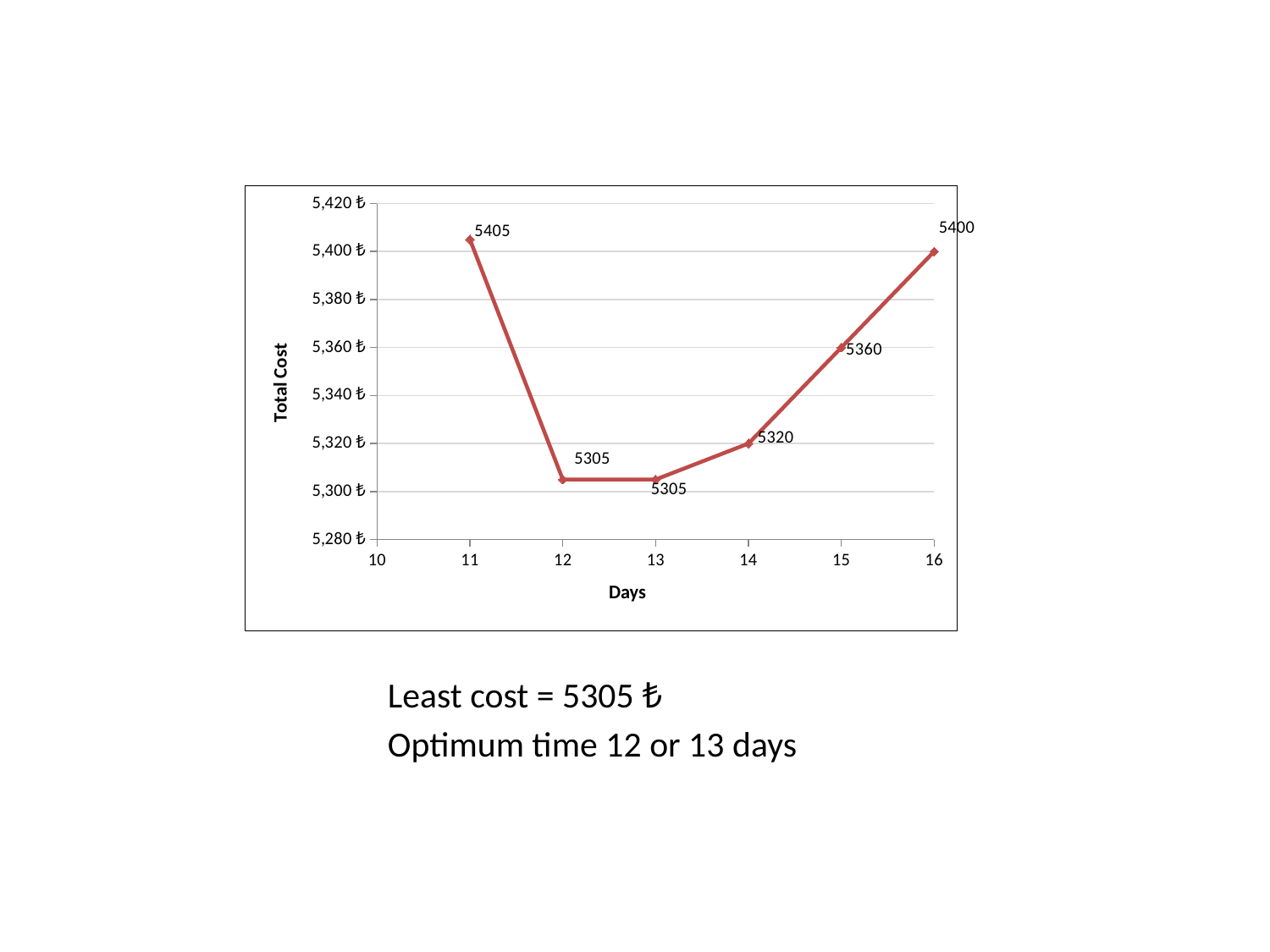
What is the lowest total cost plotted on the chart? 5305 At which number of days is the total cost highest? 11 What is the difference in total cost between 11 days and 12 days? 100 What is the difference in total cost between 16 days and 15 days? 40 Which has a higher total cost, 11 days or 16 days? 11 days What is the label of the vertical axis? Total Cost What is the total cost at 14 days? 5320 What is the total cost at 16 days? 5400 How many data points are plotted on the chart? 6 What kind of chart is shown on the slide? line chart What is the total cost at 15 days? 5360 What is the total cost at 11 days? 5405